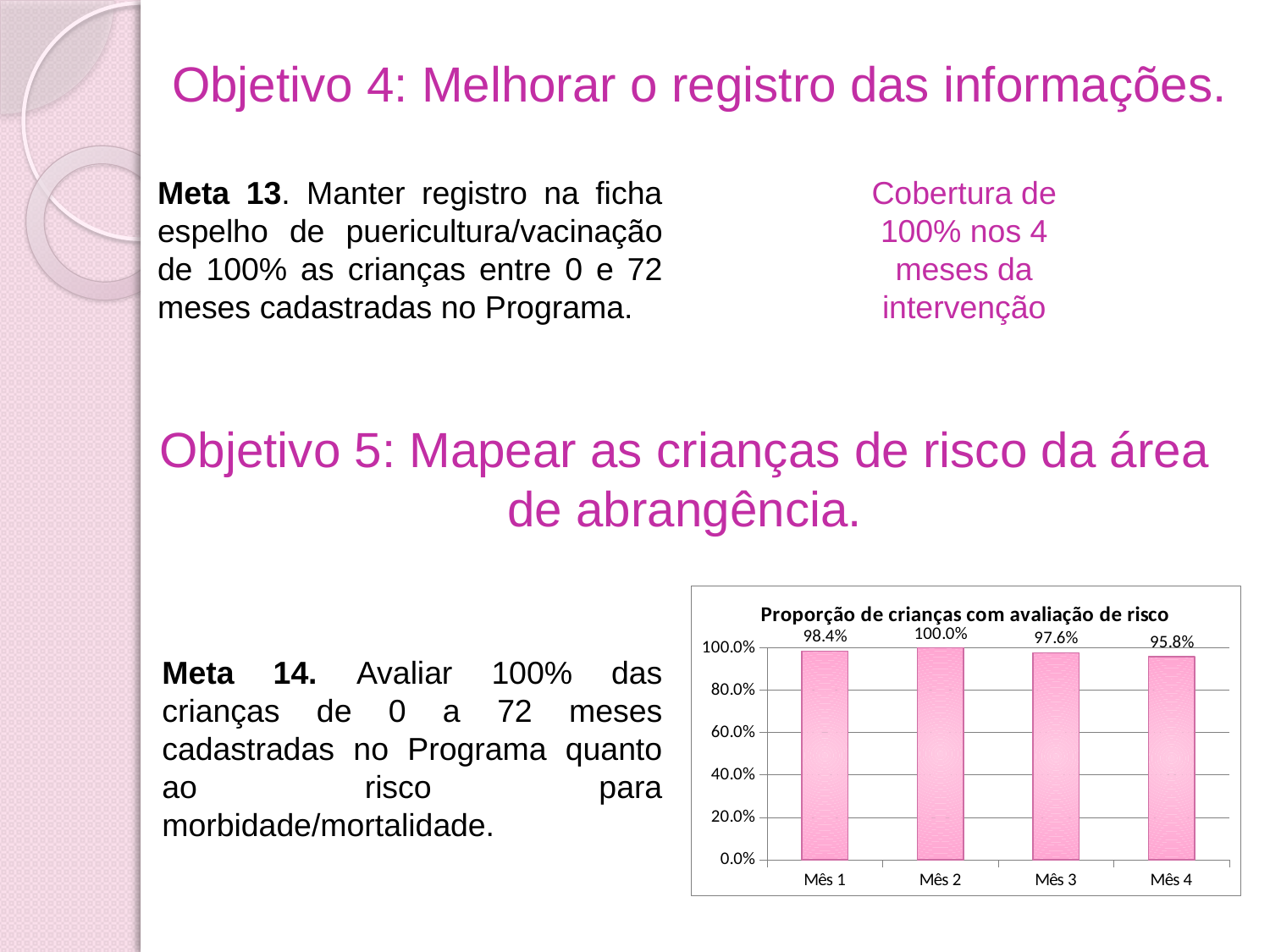
What is the difference between the values for Mês 2 and Mês 4? 4.2% Which month has the lowest value in the chart? Mês 4 What is the value for Mês 3 in the chart? 97.6% Which is larger, the value for Mês 1 or the value for Mês 3? Mês 1 What is the value for Mês 1 in the chart? 98.4% What is the value for Mês 4 in the chart? 95.8% Which month has the highest value in the chart? Mês 2 What is the value for Mês 2 in the chart? 100.0% What is the title of the chart? Proporção de crianças com avaliação de risco Is the value for Mês 4 greater or less than 80.0%? greater What kind of chart is shown on the slide? bar chart How many months are shown on the x axis of the chart? 4